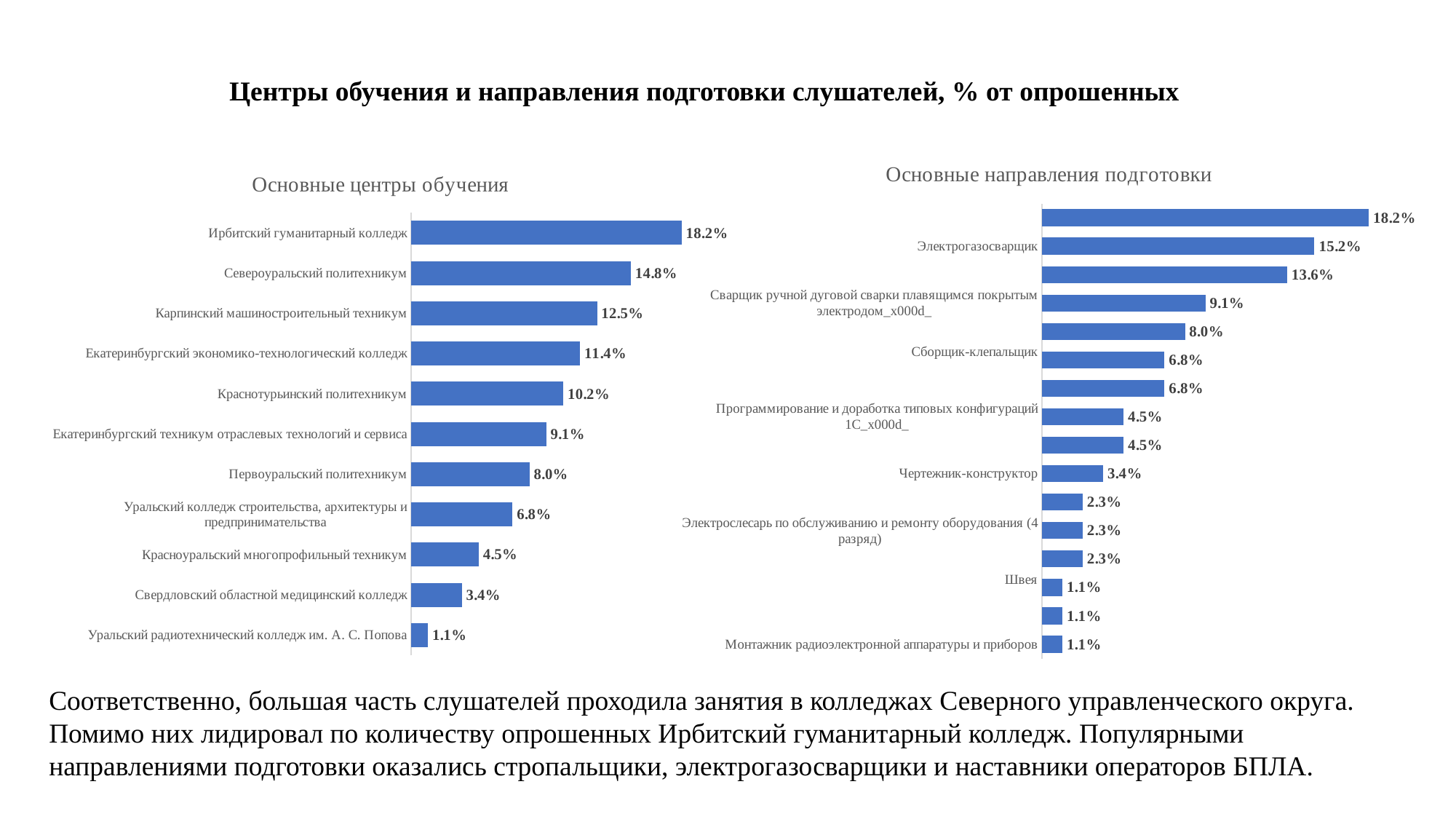
In the chart 'Основные центры обучения', what is the value for Североуральский политехникум? 14.8% In the chart 'Основные направления подготовки', what is the highest value shown? 18.2% What type of chart is 'Основные центры обучения'? Bar chart In the chart 'Основные центры обучения', which is larger: Первоуральский политехникум or Свердловский областной медицинский колледж? Первоуральский политехникум In the chart 'Основные центры обучения', which category has the lowest value? Уральский радиотехнический колледж им. А. С. Попова In the chart 'Основные направления подготовки', what is the value for Монтажник радиоэлектронной аппаратуры и приборов? 1.1% In the chart 'Основные направления подготовки', what is the value for Электрогазосварщик? 15.2% How many categories are shown in the chart 'Основные центры обучения'? 11 In the chart 'Основные центры обучения', what is the value for Краснотурьинский политехникум? 10.2% In the chart 'Основные центры обучения', what is the difference between Ирбитский гуманитарный колледж and Карпинский машиностроительный техникум? 5.7% In the chart 'Основные центры обучения', which category has the highest value? Ирбитский гуманитарный колледж In the chart 'Основные направления подготовки', what is the value for Чертежник-конструктор? 3.4%